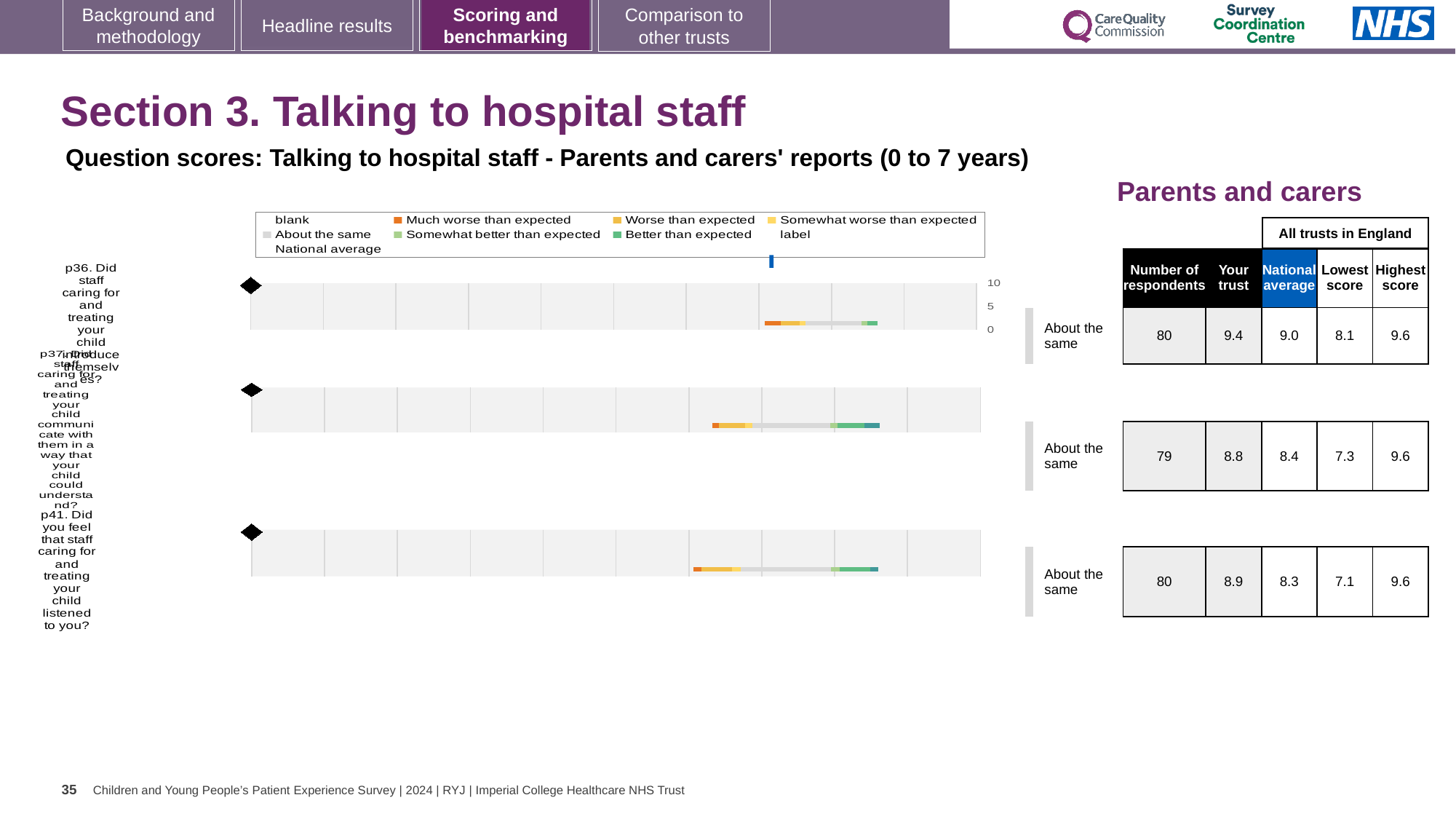
How many respondents answered p37? 79 How many questions (p36, p37, p41) are plotted in the chart? 3 Which question has the lowest National average score? p41 What kind of chart is used to show the question scores on this slide? bar chart Which has the higher 'Your trust' score, p37 or p41? p41 What is the 'Your trust' score for p36 (Did staff caring for and treating your child introduce themselves?)? 9.4 For p36, what is the difference between the 'Your trust' score and the National average? 0.4 What is the Lowest score across all trusts in England for p41 (Did you feel that staff listened to you?)? 7.1 Which question has the highest 'Your trust' score? p36 What is the maximum value shown on the chart's score axis? 10 What is the National average score for p37 (Did staff communicate with your child in a way they could understand?)? 8.4 What benchmark category is shown for p36? About the same